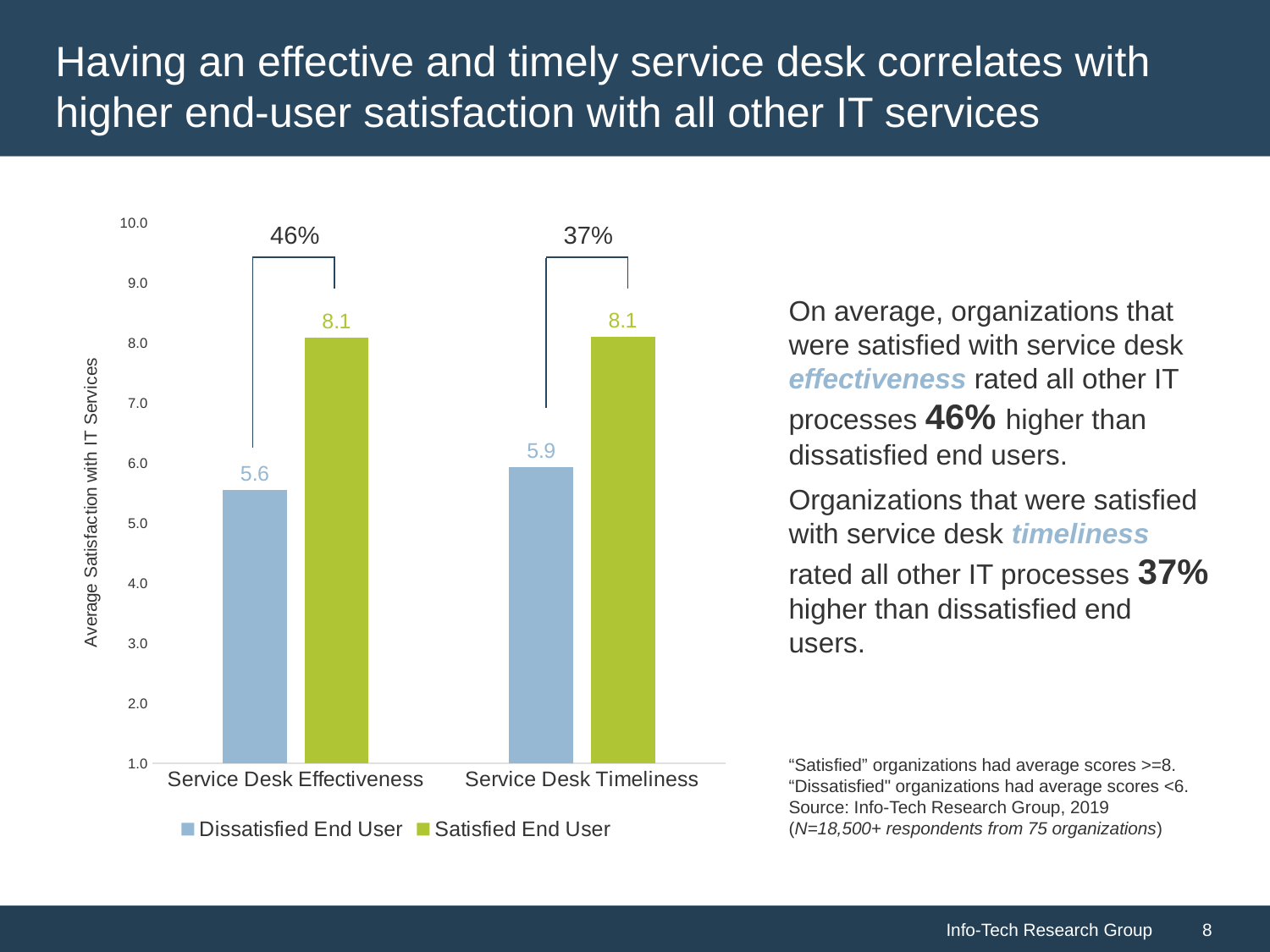
What is the value for Satisfied End User under Service Desk Effectiveness? 8.1 What kind of chart is shown on the slide? bar chart What is the difference between the Satisfied End User and Dissatisfied End User values for Service Desk Timeliness? 2.2 What is the value for Dissatisfied End User under Service Desk Timeliness? 5.9 Which is larger: the Dissatisfied End User value for Service Desk Effectiveness or for Service Desk Timeliness? Service Desk Timeliness What is the value for Dissatisfied End User under Service Desk Effectiveness? 5.6 What is the value for Satisfied End User under Service Desk Timeliness? 8.1 How many series does the legend list? 2 Is the Dissatisfied End User value for Service Desk Timeliness greater or less than 7.0? less How many categories are shown on the x axis? 2 Which category has the lowest Dissatisfied End User value? Service Desk Effectiveness What is the difference between the Satisfied End User and Dissatisfied End User values for Service Desk Effectiveness? 2.5